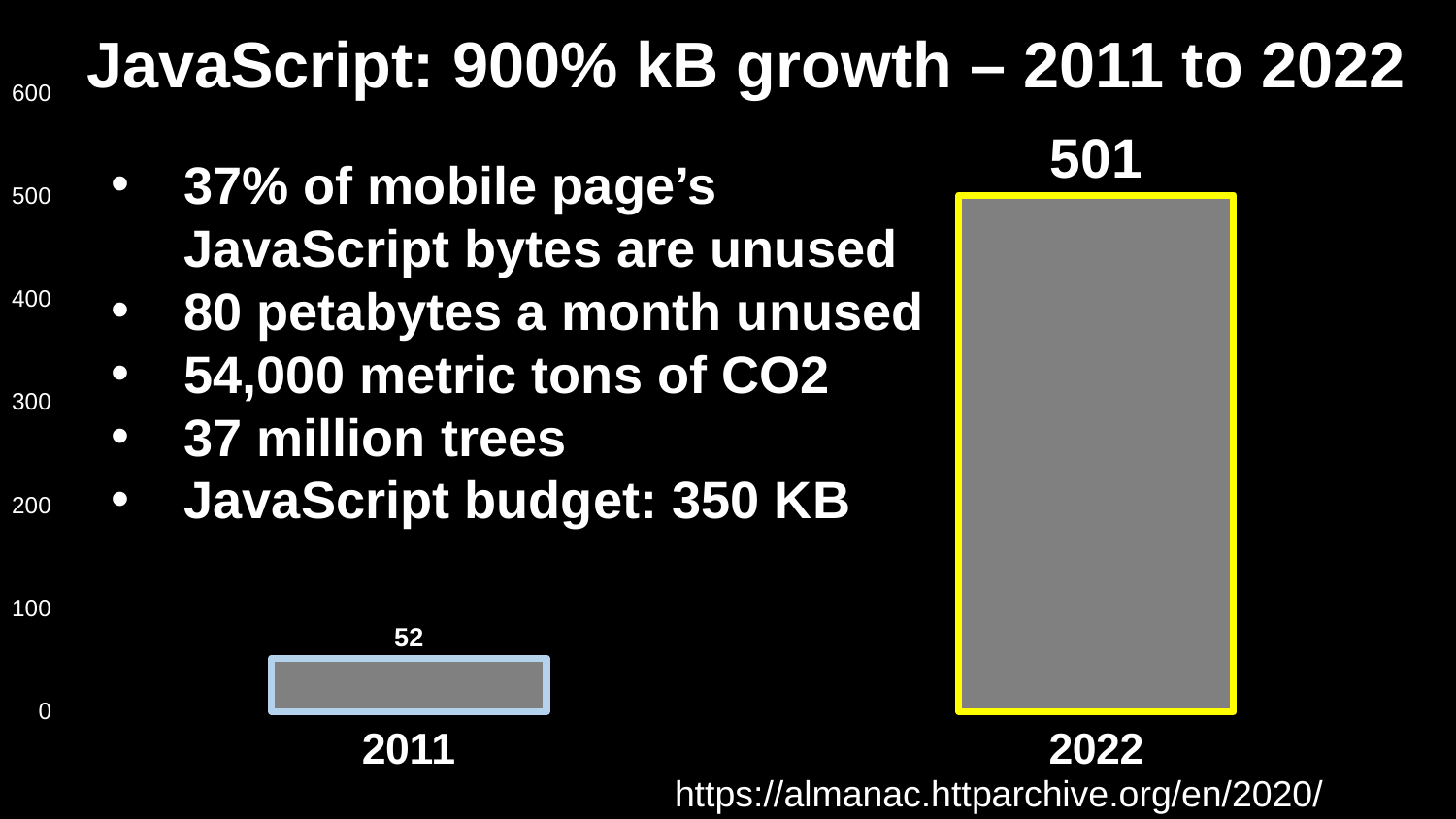
Which year has the lowest value? 2011 Is the value for 2011 greater or less than 100? less What is the value for 2022? 501 What is the value for 2011? 52 Which year has the highest value? 2022 Do the values rise or fall from 2011 to 2022? rise What kind of chart is shown on the slide? bar chart How many bars are shown in the chart? 2 What is the title of the slide containing the chart? JavaScript: 900% kB growth – 2011 to 2022 Is the value for 2022 greater or less than 400? greater What is the difference between the values for 2022 and 2011? 449 Which is larger, the value for 2011 or the value for 2022? 2022